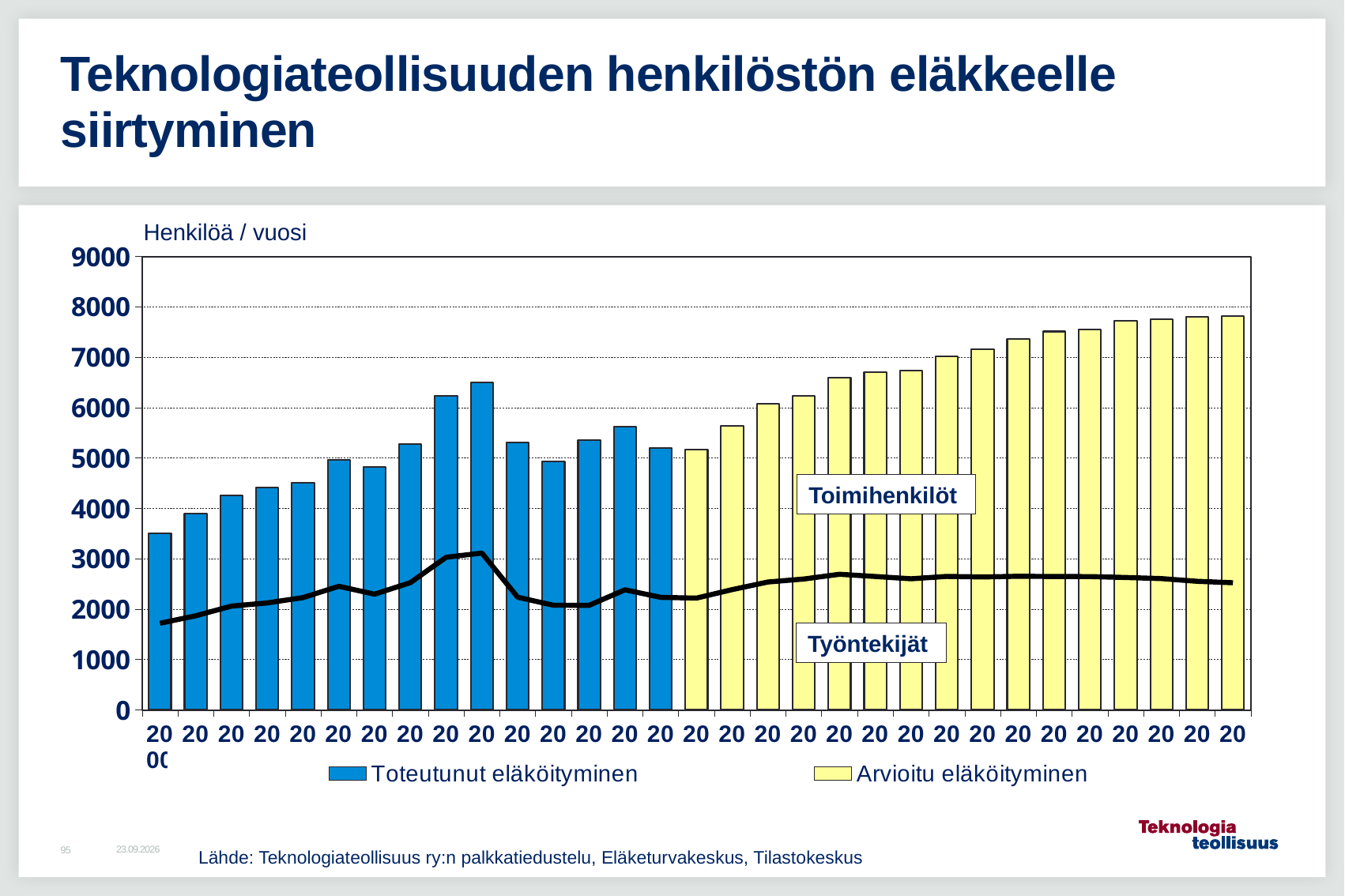
How many bars are plotted in the chart? 31 Which is larger, the first blue bar or the first yellow bar? the first yellow bar What is the label on the vertical axis? Henkilöä / vuosi Do the yellow (Arvioitu eläköityminen) bars rise or fall from left to right? rise How many series does the legend list? 2 Is the value of the black line at its highest point greater or less than 3000? greater Is the value of the tallest blue (Toteutunut eläköityminen) bar greater or less than 6000? greater Is the value of the last (rightmost) bar greater or less than 8000? less Which bar is the highest in the chart, the first bar or the last bar? the last bar What are the two legend entries? Toteutunut eläköityminen, Arvioitu eläköityminen What kind of chart is shown on the slide? bar and line chart